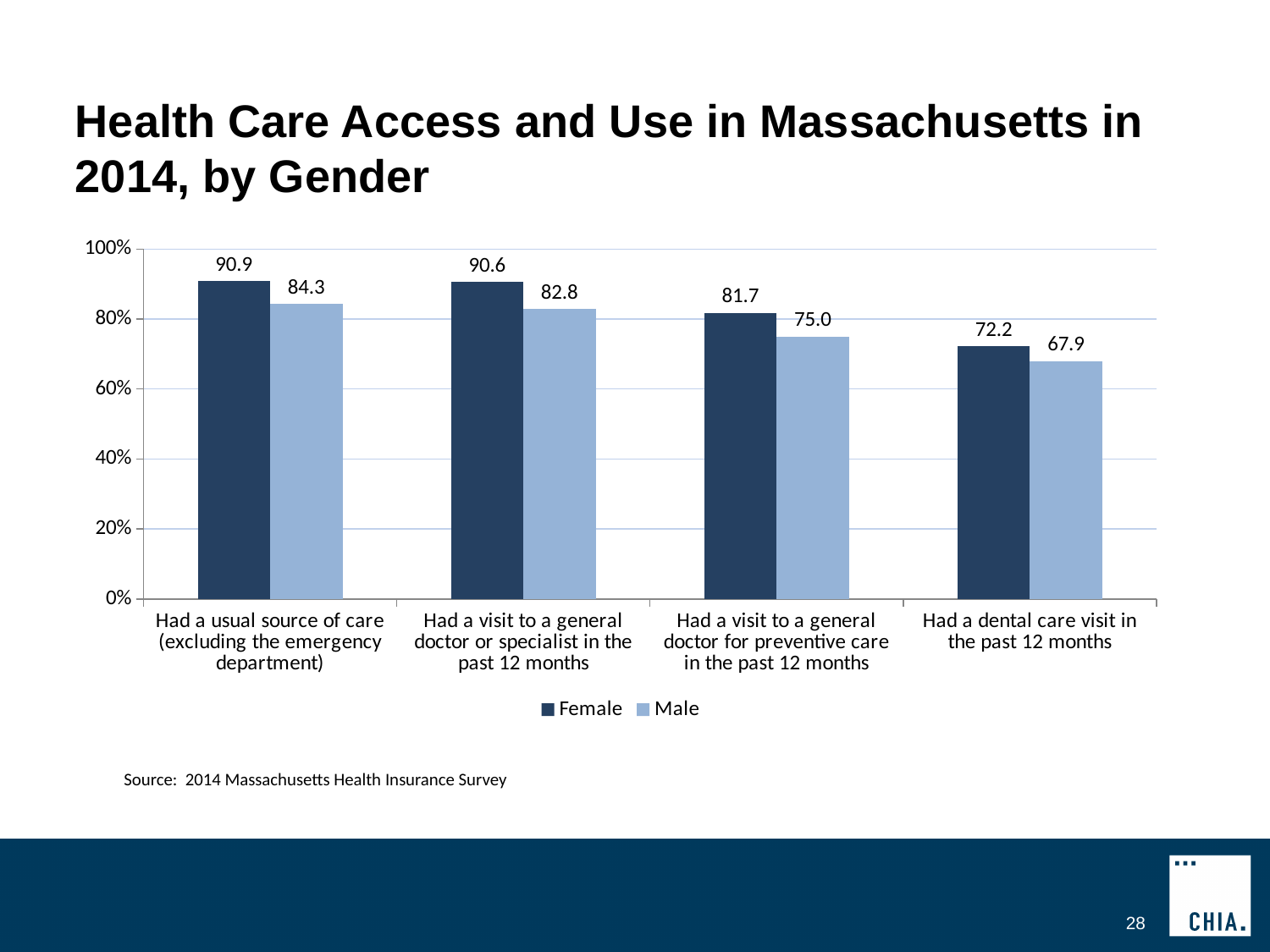
How many categories are shown on the x axis? 4 What is the Male value for 'Had a dental care visit in the past 12 months'? 67.9 What is the difference between the Female and Male values for 'Had a visit to a general doctor or specialist in the past 12 months'? 7.8 Is the Male value for 'Had a dental care visit in the past 12 months' greater or less than 80%? less Which category has the highest Male value? Had a usual source of care (excluding the emergency department) What kind of chart is shown on the slide? Bar chart Which is larger for 'Had a visit to a general doctor for preventive care in the past 12 months': the Female value or the Male value? Female What is the Female value for 'Had a usual source of care (excluding the emergency department)'? 90.9 What is the source cited below the chart? 2014 Massachusetts Health Insurance Survey What is the Male value for 'Had a visit to a general doctor for preventive care in the past 12 months'? 75.0 How many series does the legend list? 2 Which category has the lowest Female value? Had a dental care visit in the past 12 months